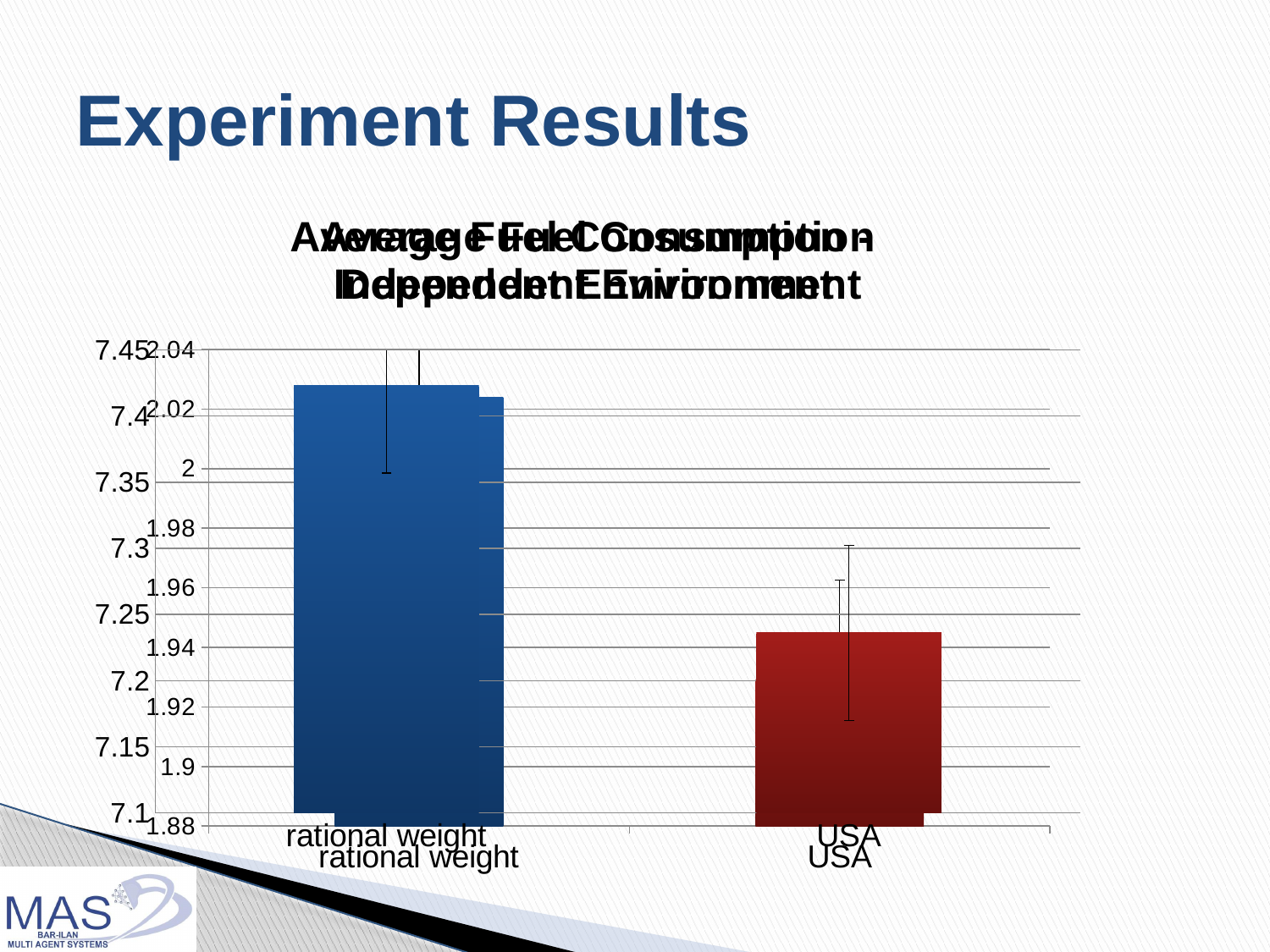
What colour is the bar for rational weight? blue Which category has the tallest bar in the chart? rational weight Which category has the shortest bar in the chart? USA Which has the larger value, rational weight or USA? rational weight What colour is the bar for USA? red What kind of chart is shown on the slide? bar chart How many categories are shown on the x axis of the chart? 2